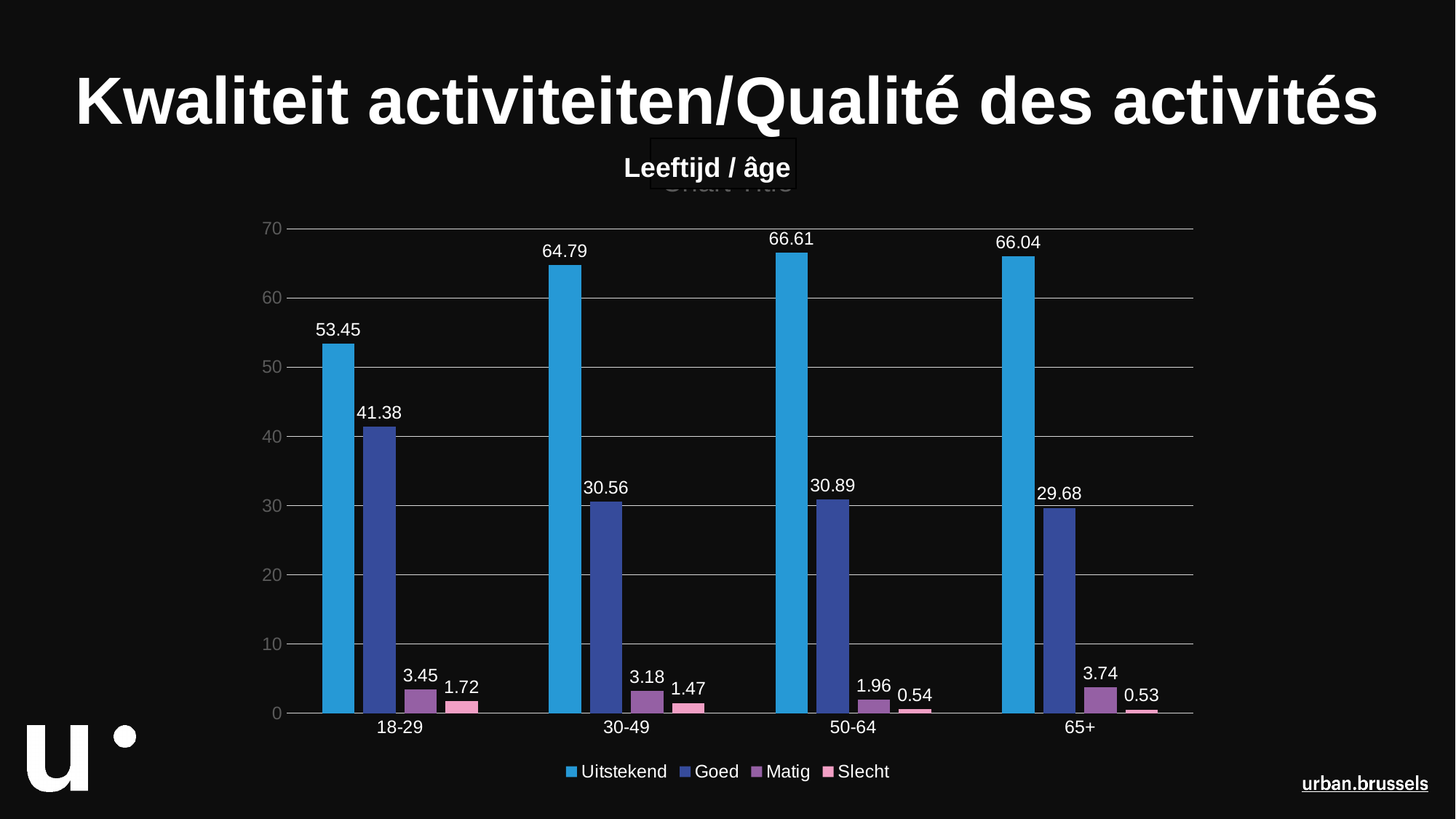
What is the value for Slecht in the 65+ age group? 0.53 What is the difference between the Uitstekend values for 50-64 and 18-29? 13.16 What is the value for Goed in the 18-29 age group? 41.38 What is the subtitle shown above the chart? Leeftijd / âge Is the Uitstekend value for 18-29 greater or less than 50? greater Which age group has the lowest Goed value? 65+ What is the value for Uitstekend in the 30-49 age group? 64.79 What kind of chart is shown on the slide? bar chart How many age groups are shown on the x axis? 4 Which is larger: the Matig value for 18-29 or the Matig value for 65+? 65+ How many series does the legend list? 4 Which age group has the highest Uitstekend value? 50-64